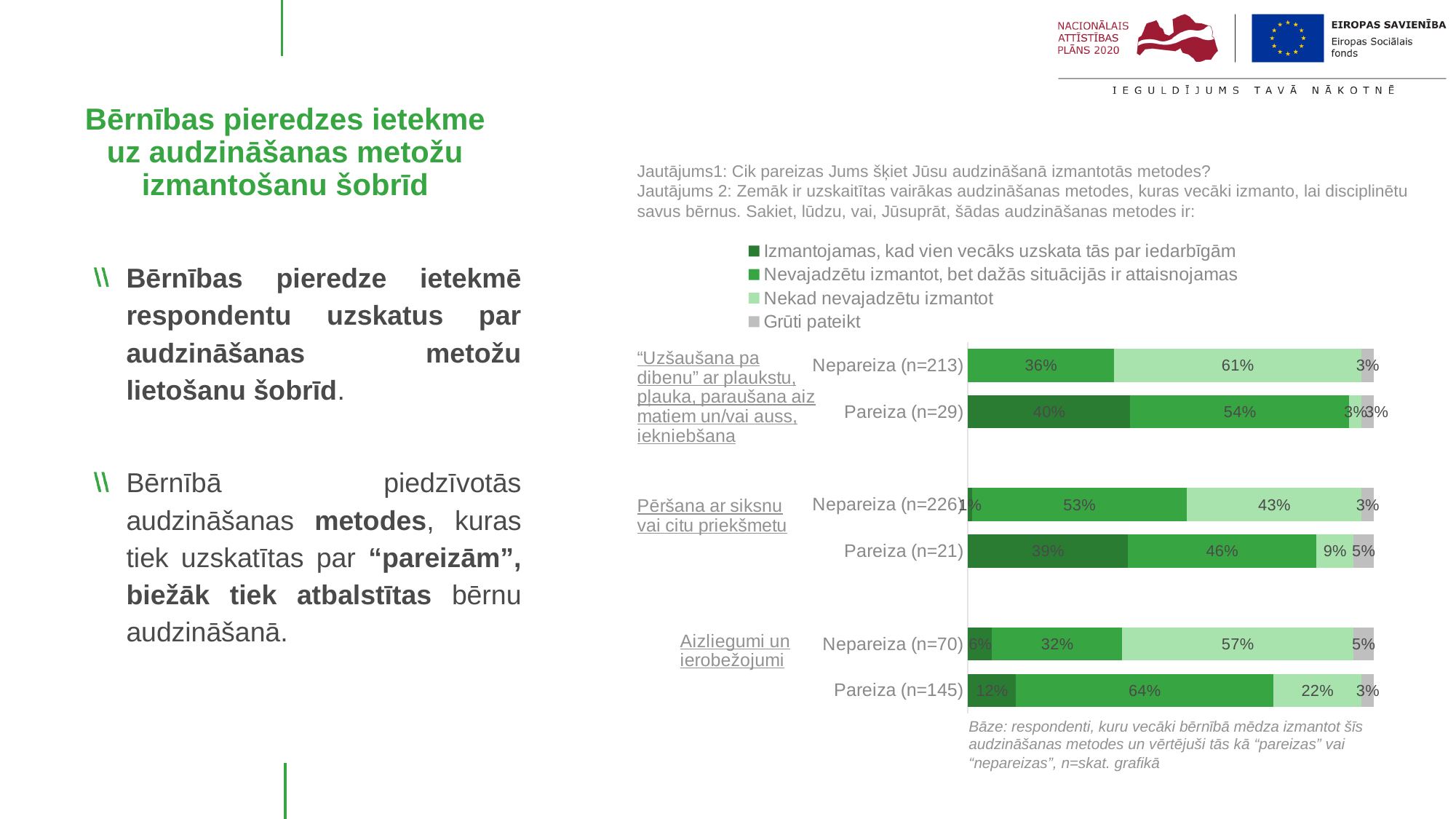
What is the value of "Nevajadzētu izmantot, bet dažās situācijās ir attaisnojamas" for Pareiza (n=145) in the "Aizliegumi un ierobežojumi" group? 64% What kind of chart is shown on the slide? stacked bar chart What is the value of "Nevajadzētu izmantot, bet dažās situācijās ir attaisnojamas" for Nepareiza (n=226) in the "Pēršana ar siksnu vai citu priekšmetu" group? 53% How many series does the legend list? 4 What is the value of "Grūti pateikt" for Pareiza (n=21) in the "Pēršana ar siksnu vai citu priekšmetu" group? 5% What is the value of "Nekad nevajadzētu izmantot" for Nepareiza (n=213) in the "Uzšaušana pa dibenu" group? 61% Which bar has the highest value for "Nekad nevajadzētu izmantot"? Nepareiza (n=213) What is the difference between the "Nekad nevajadzētu izmantot" values for Nepareiza (n=70) and Pareiza (n=145) in the "Aizliegumi un ierobežojumi" group? 35 percentage points Which legend entry is shown in grey? Grūti pateikt Which is larger: the "Izmantojamas, kad vien vecāks uzskata tās par iedarbīgām" value for Pareiza (n=21) or for Pareiza (n=145)? Pareiza (n=21) What is the value of "Izmantojamas, kad vien vecāks uzskata tās par iedarbīgām" for Pareiza (n=29) in the "Uzšaušana pa dibenu" group? 40% How many bars are plotted in the chart? 6